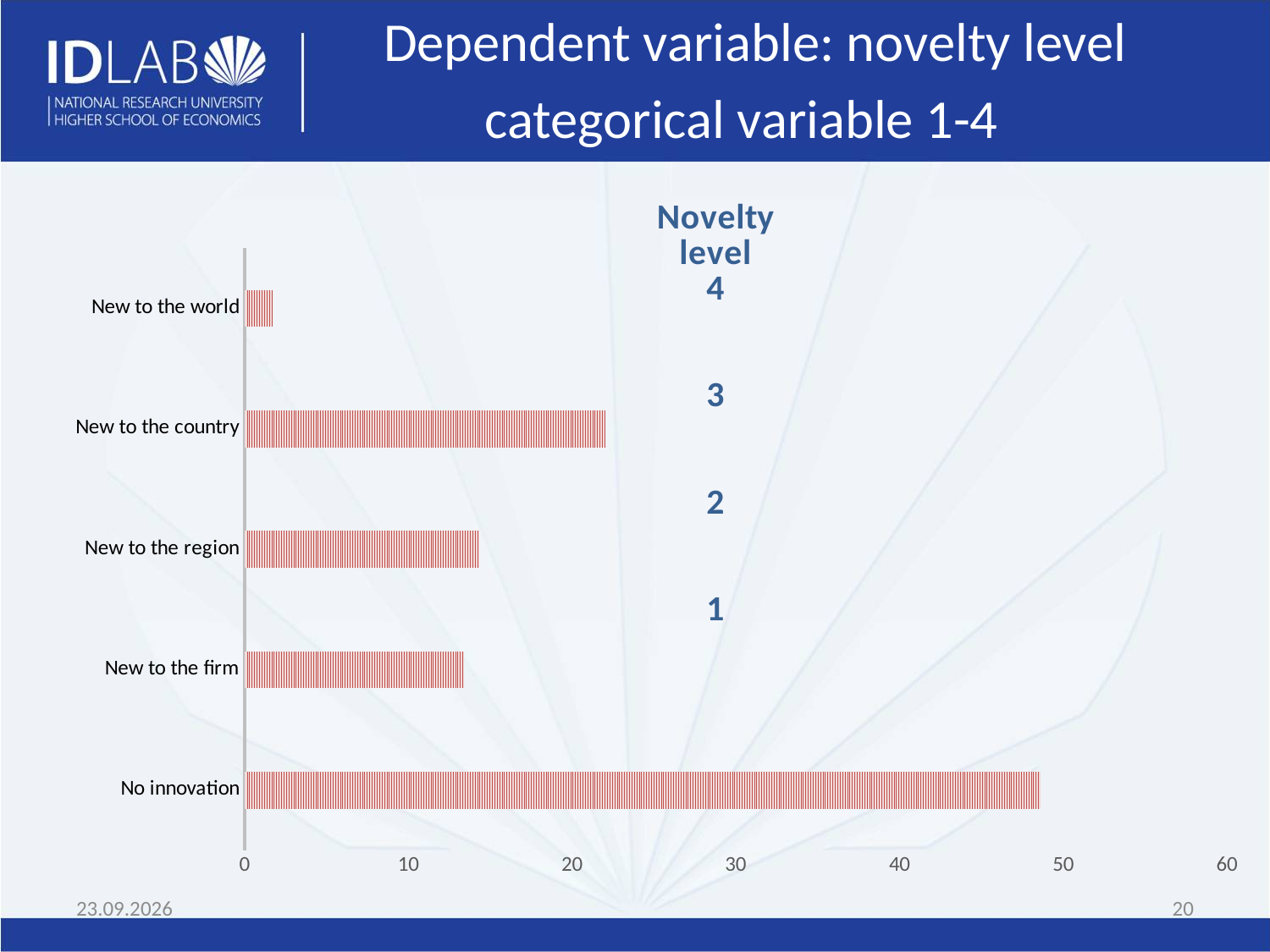
Is the value for No innovation greater or less than 40? greater Is the value for New to the country greater or less than 20? greater Which is larger, the value for New to the country or the value for New to the region? New to the country Is the value for New to the region greater or less than 20? less Which category has the lowest value? New to the world What novelty level number is shown next to the New to the world bar? 4 Which is larger, the value for No innovation or the value for New to the country? No innovation What is the highest tick value shown on the horizontal axis? 60 Which category has the highest value? No innovation How many categories are plotted in the chart? 5 What kind of chart is shown on the slide? bar chart